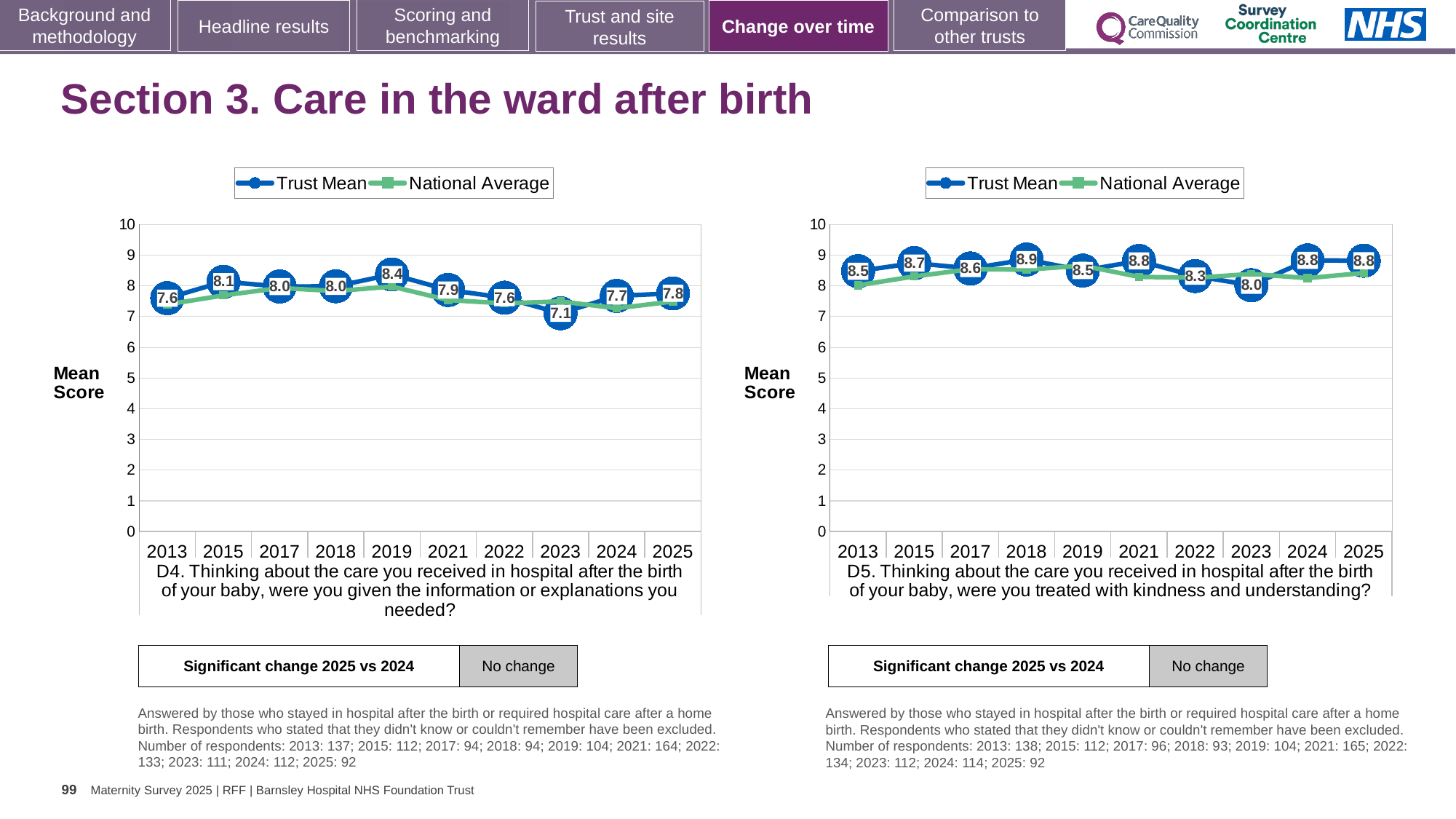
In the D4 chart on the left, which year has the highest Trust Mean? 2019 In the D4 chart on the left, which year has the lowest Trust Mean? 2023 How many years are shown on the x axis of the D5 chart on the right? 10 In the D5 chart on the right, what is the Trust Mean for 2018? 8.9 In the D4 chart on the left, what is the Trust Mean for 2019? 8.4 In the D5 chart on the right, is the Trust Mean higher in 2018 or in 2022? 2018 In the D5 chart on the right, what is the Trust Mean for 2025? 8.8 In the D4 chart on the left, what is the Trust Mean for 2023? 7.1 What type of chart is the D4 chart on the left? Line chart In the D5 chart on the right, which year has the lowest Trust Mean? 2023 In the D4 chart on the left, what is the difference between the Trust Mean in 2019 and in 2023? 1.3 How many series does the legend of the D4 chart on the left list? 2